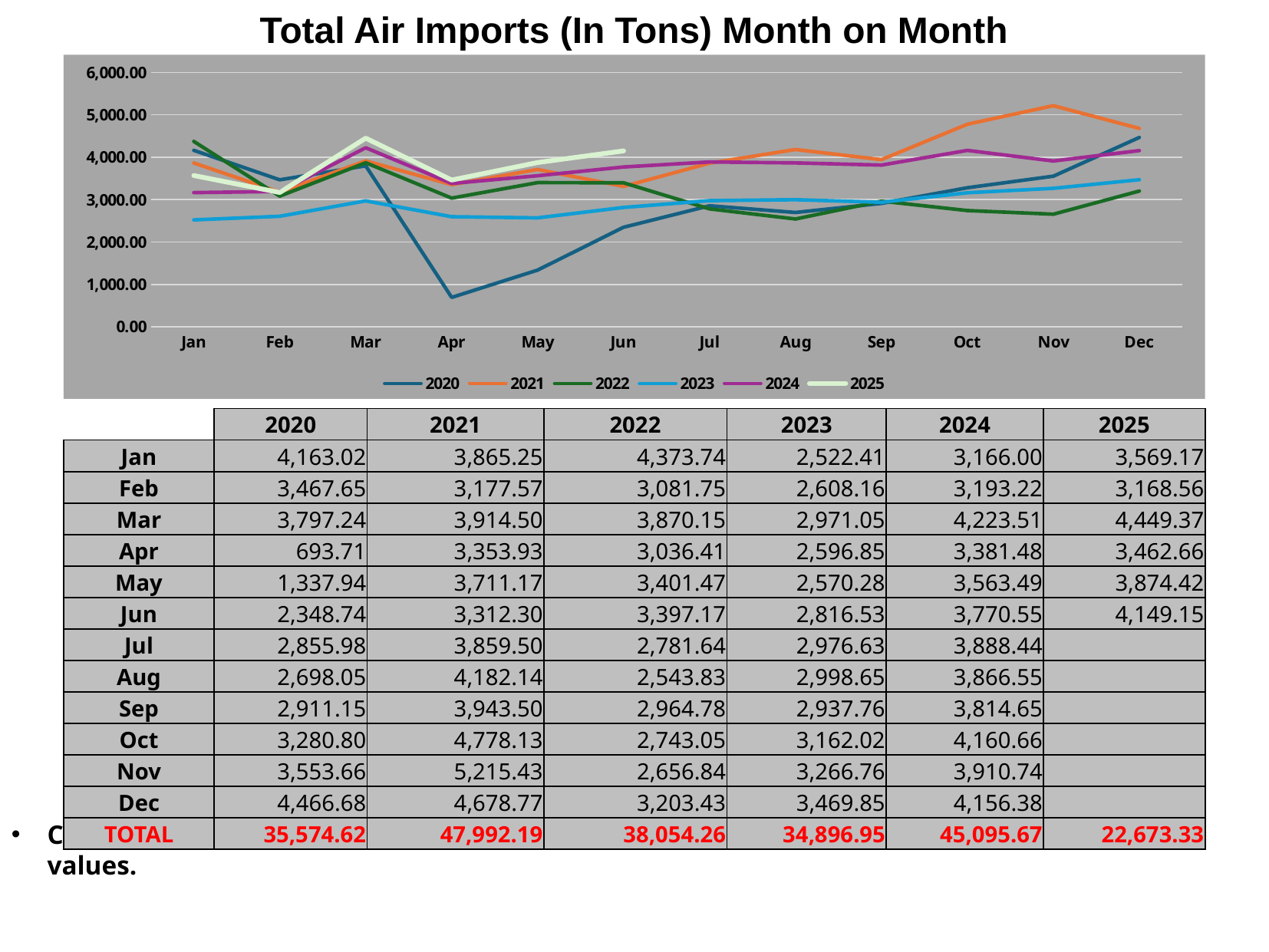
Which month has the lowest value in the 2020 series? Apr Which month has the highest value in the 2021 series? Nov What kind of chart is shown on the slide? line chart How many series does the legend list? 6 What is the value for June in the 2025 series? 4,149.15 What is the title of the chart? Total Air Imports (In Tons) Month on Month Is the value for April in the 2020 series greater or less than 1,000.00? less What is the value for November in the 2021 series? 5,215.43 What is the difference between the March values for 2025 and 2024? 225.86 Which series has the larger value in January, 2020 or 2022? 2022 What is the value for April in the 2020 series? 693.71 How many months are plotted along the x axis? 12